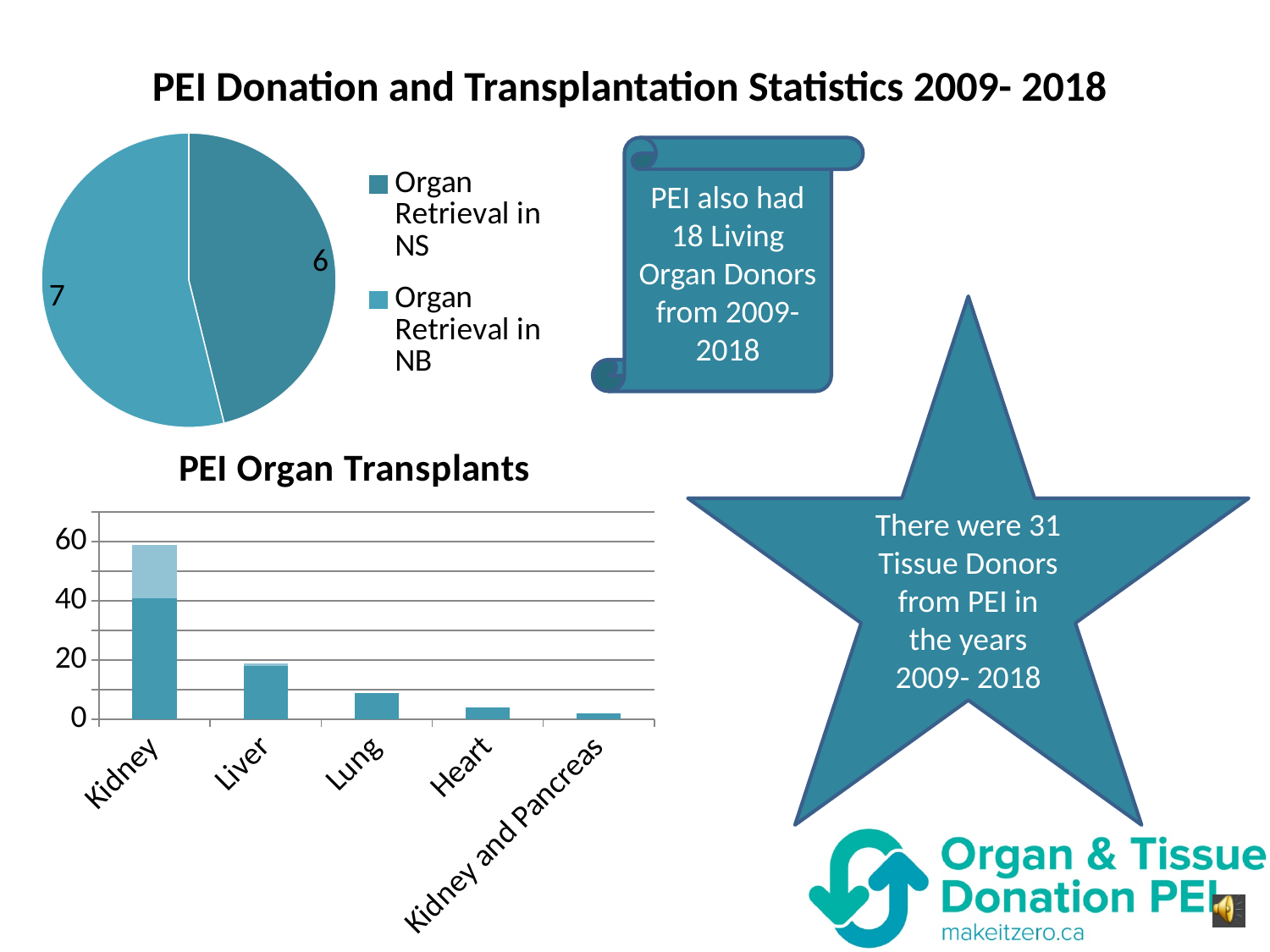
In the pie chart at the top left, what is the value for Organ Retrieval in NB? 7 How many entries does the legend of the pie chart at the top left list? 2 What kind of chart is the chart at the top left of the slide? Pie chart In the pie chart at the top left, what is the value for Organ Retrieval in NS? 6 In the pie chart at the top left, what is the difference between Organ Retrieval in NB and Organ Retrieval in NS? 1 In the PEI Organ Transplants chart, which category has the highest value? Kidney What kind of chart is the PEI Organ Transplants chart? Bar chart In the pie chart at the top left, which is larger: Organ Retrieval in NS or Organ Retrieval in NB? Organ Retrieval in NB In the PEI Organ Transplants chart, which category has the lowest value? Kidney and Pancreas In the PEI Organ Transplants chart, do the values rise or fall from left to right along the x axis? fall In the PEI Organ Transplants chart, is the value for Lung greater or less than 20? less How many categories are shown on the x axis of the PEI Organ Transplants chart? 5